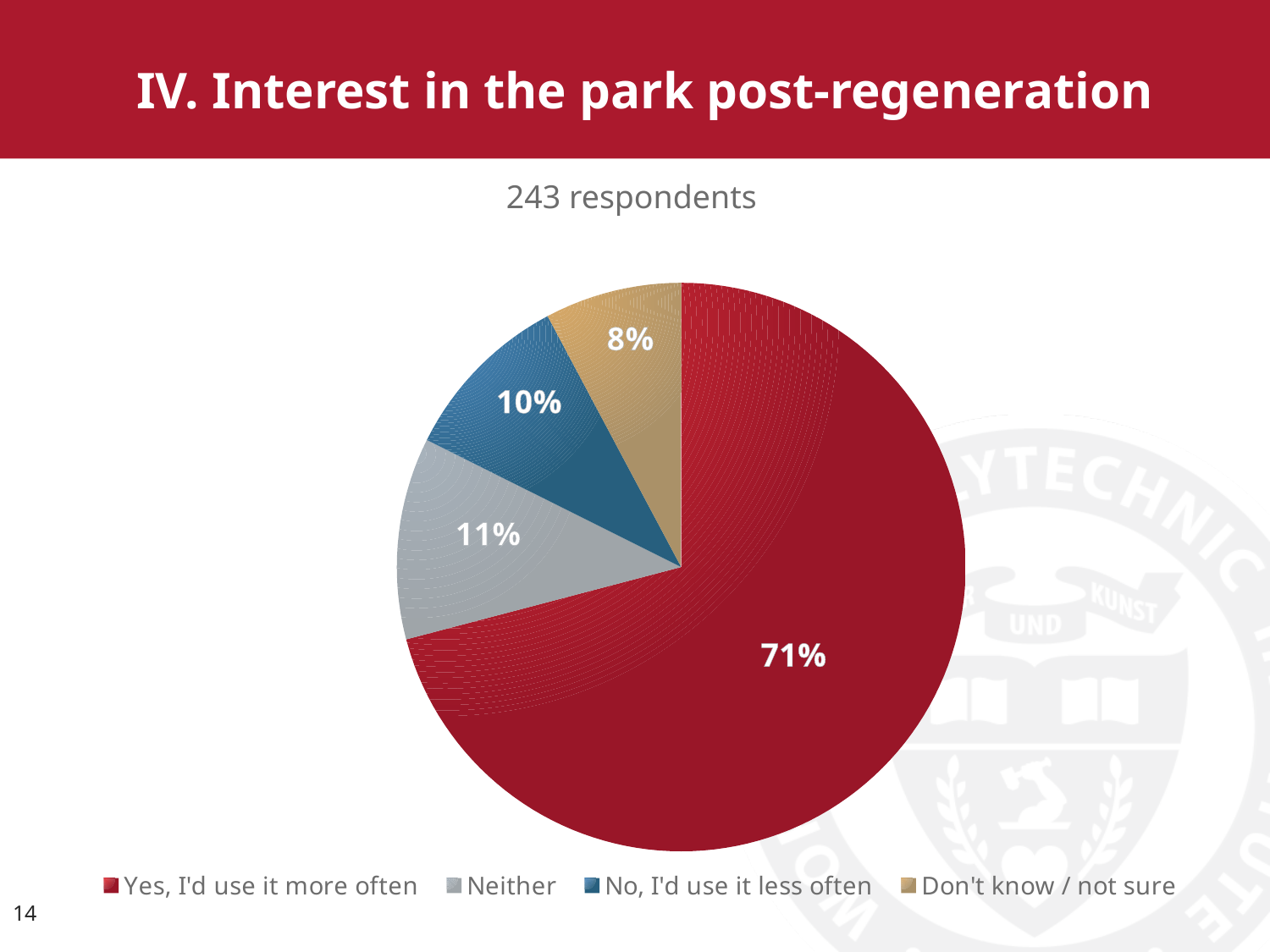
What is the title shown above the pie chart? 243 respondents What share of respondents said "No, I'd use it less often"? 10% Which is larger: the share for "Neither" or the share for "Don't know / not sure"? Neither What share of respondents answered "Don't know / not sure"? 8% What share of respondents answered "Neither"? 11% Which response has the smallest slice of the pie? Don't know / not sure What kind of chart is shown on the slide? pie chart How many slices does the pie chart have? 4 Which response has the largest slice of the pie? Yes, I'd use it more often What is the difference in percentage points between "Yes, I'd use it more often" and "Neither"? 60 What colour is the slice for "No, I'd use it less often"? blue